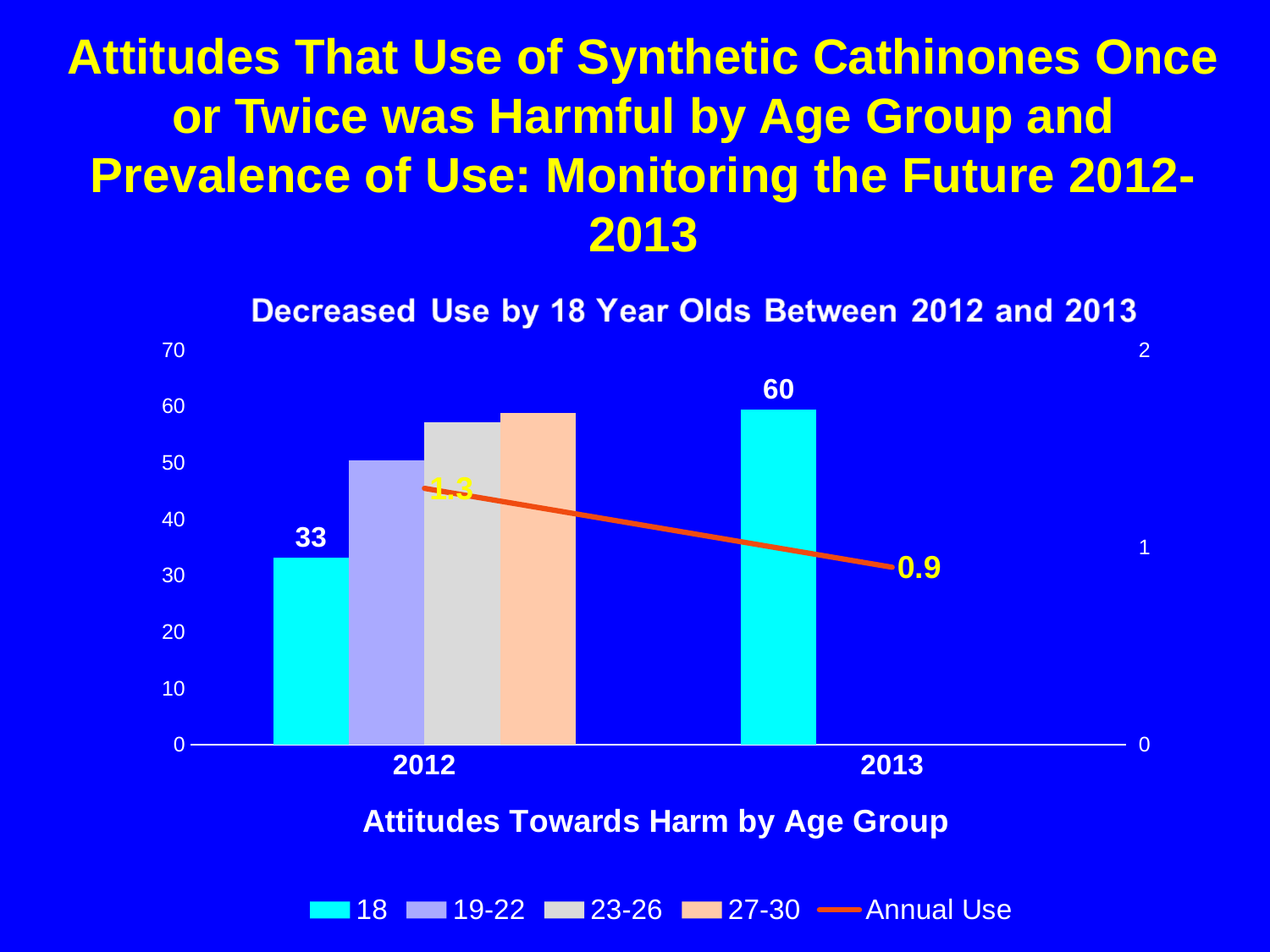
Is the value for the 19-22 age group in 2012 greater or less than 40? greater How many series does the legend list? 5 What is the value for the 18 age group in 2012? 33 Does the Annual Use line rise or fall from 2012 to 2013? fall What is the Annual Use value in 2013? 0.9 Which year has the larger value for the 18 age group, 2012 or 2013? 2013 By how much did the value for the 18 age group increase from 2012 to 2013? 27 What is the Annual Use value in 2012? 1.3 Is the value for the 23-26 age group in 2012 greater or less than 60? less What is the difference between the Annual Use values for 2012 and 2013? 0.4 Which age group has the lowest bar in 2012? 18 What is the value for the 18 age group in 2013? 60